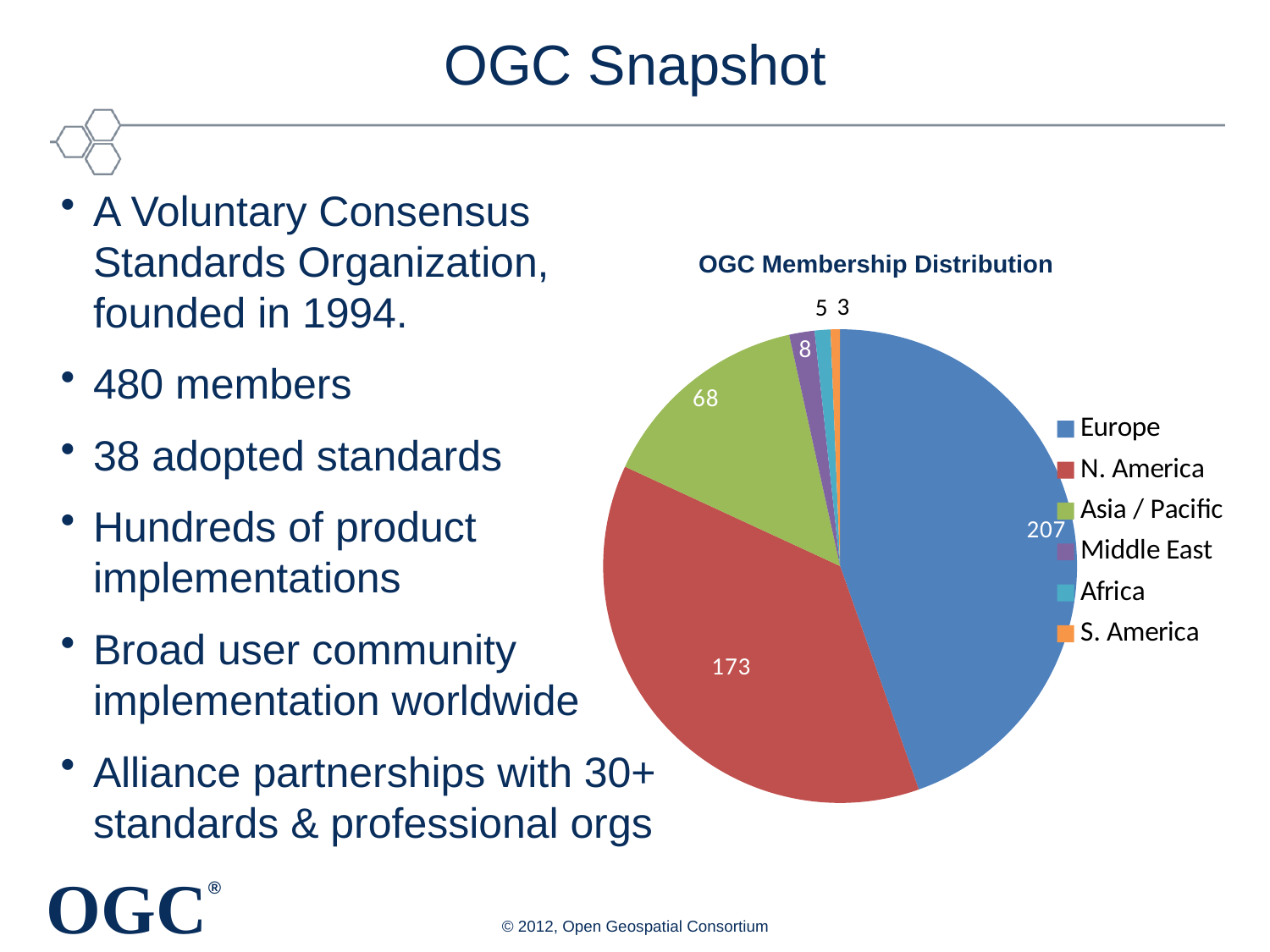
Which is larger, the value for Asia / Pacific or the value for Middle East? Asia / Pacific What is the value for N. America in the OGC Membership Distribution chart? 173 Which region has the smallest slice in the OGC Membership Distribution chart? S. America What type of chart is shown on the slide? pie chart What is the value for Middle East in the OGC Membership Distribution chart? 8 What is the value for Europe in the OGC Membership Distribution chart? 207 What is the title of the chart? OGC Membership Distribution Which region has the largest slice in the OGC Membership Distribution chart? Europe What colour is the Europe slice in the pie chart? blue What is the difference between the values for Europe and N. America? 34 What is the value for Asia / Pacific in the OGC Membership Distribution chart? 68 How many categories does the legend of the pie chart list? 6